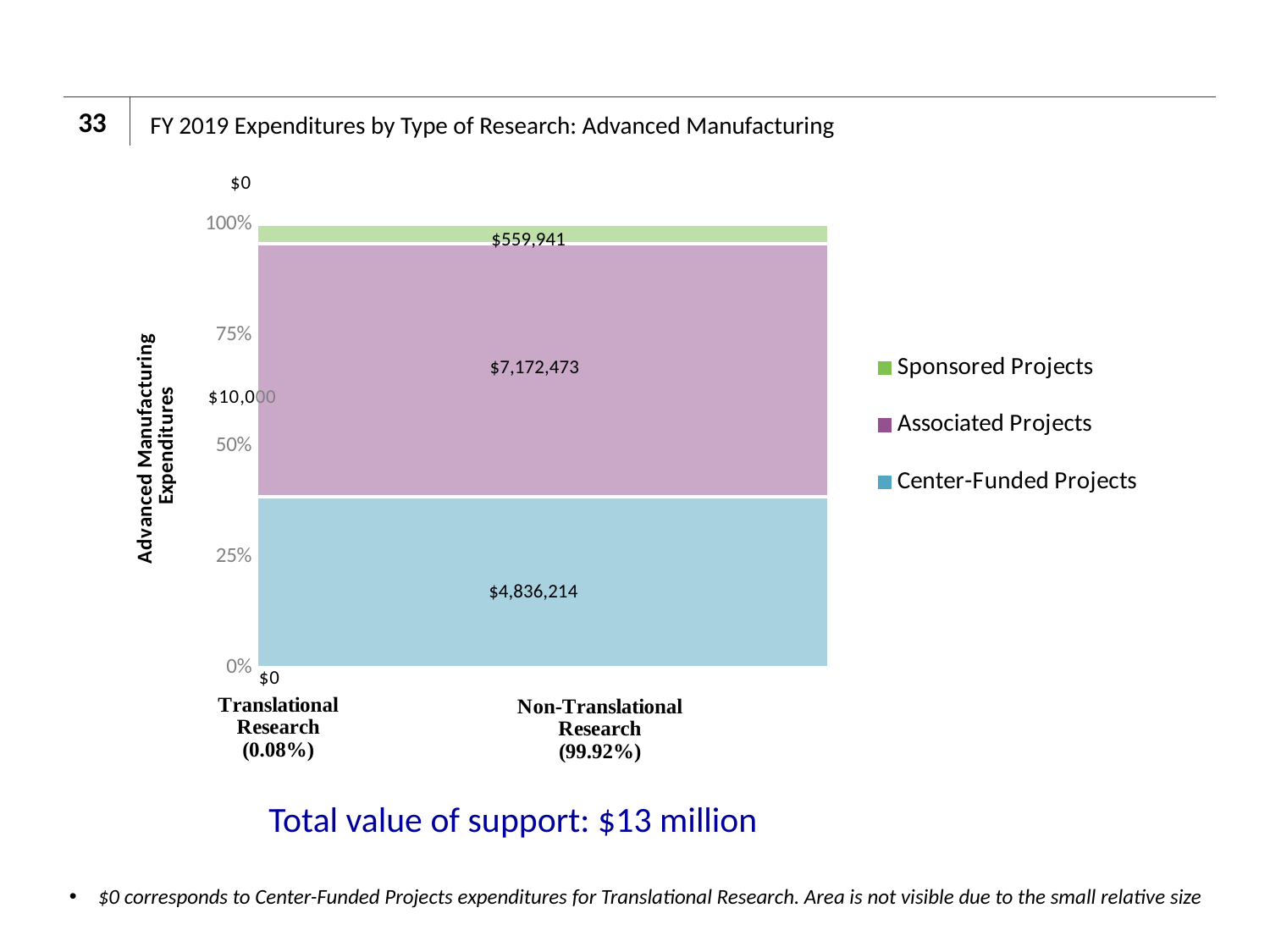
How many research categories are shown on the x axis? 2 What type of chart is shown on the slide? Stacked bar chart What percentage of Advanced Manufacturing expenditures is Non-Translational Research, according to the category label? 99.92% What is the total expenditure for Non-Translational Research across all three series? $12,568,628 What is the Associated Projects expenditure for Non-Translational Research? $7,172,473 Which series has the smallest expenditure for Non-Translational Research? Sponsored Projects How many series does the legend list? 3 Which legend entry is shown in green? Sponsored Projects What is the Center-Funded Projects expenditure for Non-Translational Research? $4,836,214 What is the difference between Associated Projects and Center-Funded Projects expenditures for Non-Translational Research? $2,336,259 Which series has the largest expenditure for Non-Translational Research? Associated Projects What is the Sponsored Projects expenditure for Non-Translational Research? $559,941